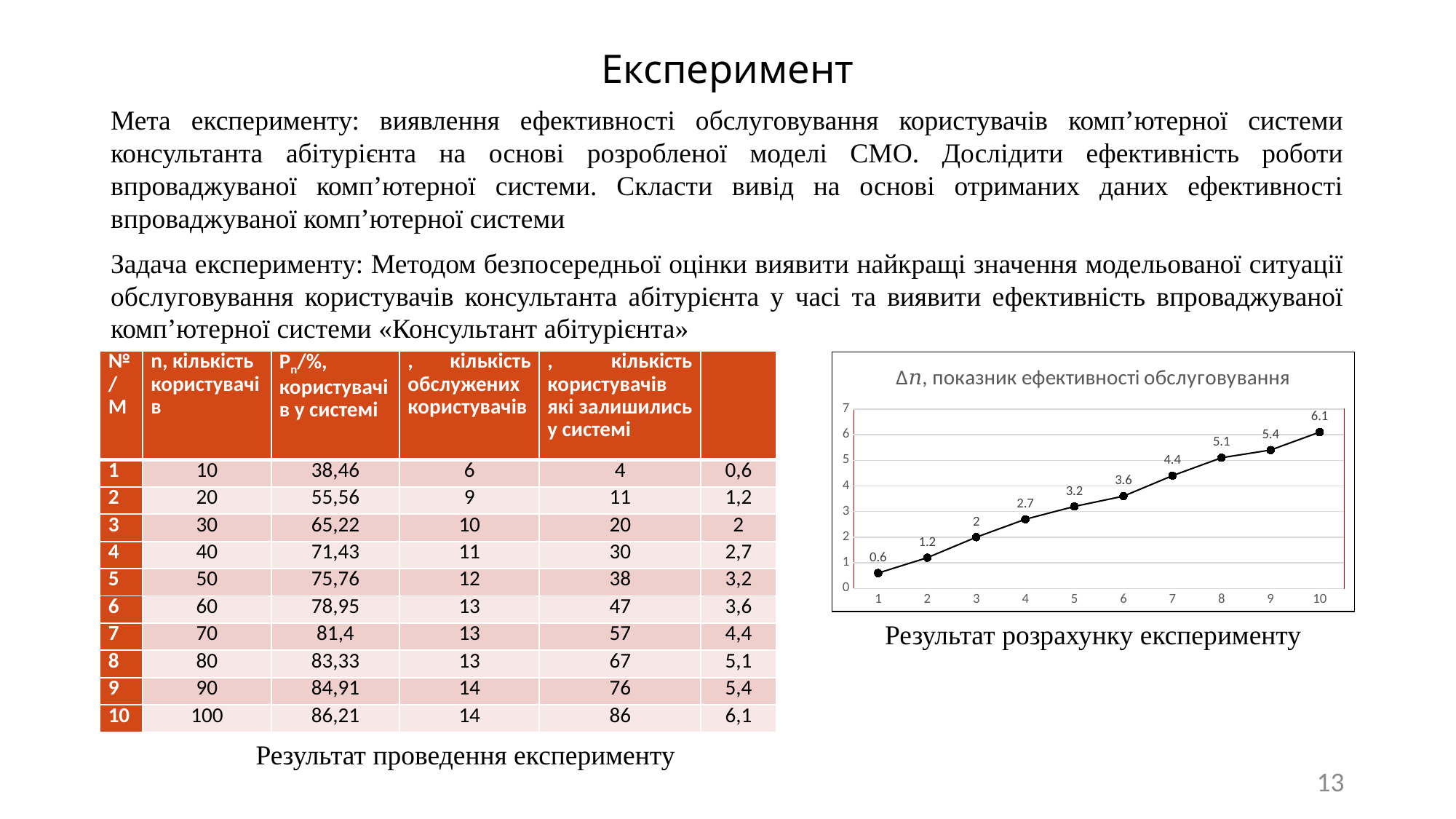
What is the value at point 7 on the chart? 4.4 Which point on the x axis has the highest value? 10 Is the value at point 8 greater or less than 5? greater How many data points are plotted on the chart? 10 What is the title of the chart? Δn, показник ефективності обслуговування What is the value at point 1 on the chart? 0.6 Do the values rise or fall as the x axis goes from 1 to 10? rise What type of chart is shown on the slide? line chart Which is larger, the value at point 4 or the value at point 6? point 6 Which point on the x axis has the lowest value? 1 What is the value at point 10 on the chart? 6.1 What is the difference between the values at point 10 and point 1? 5.5